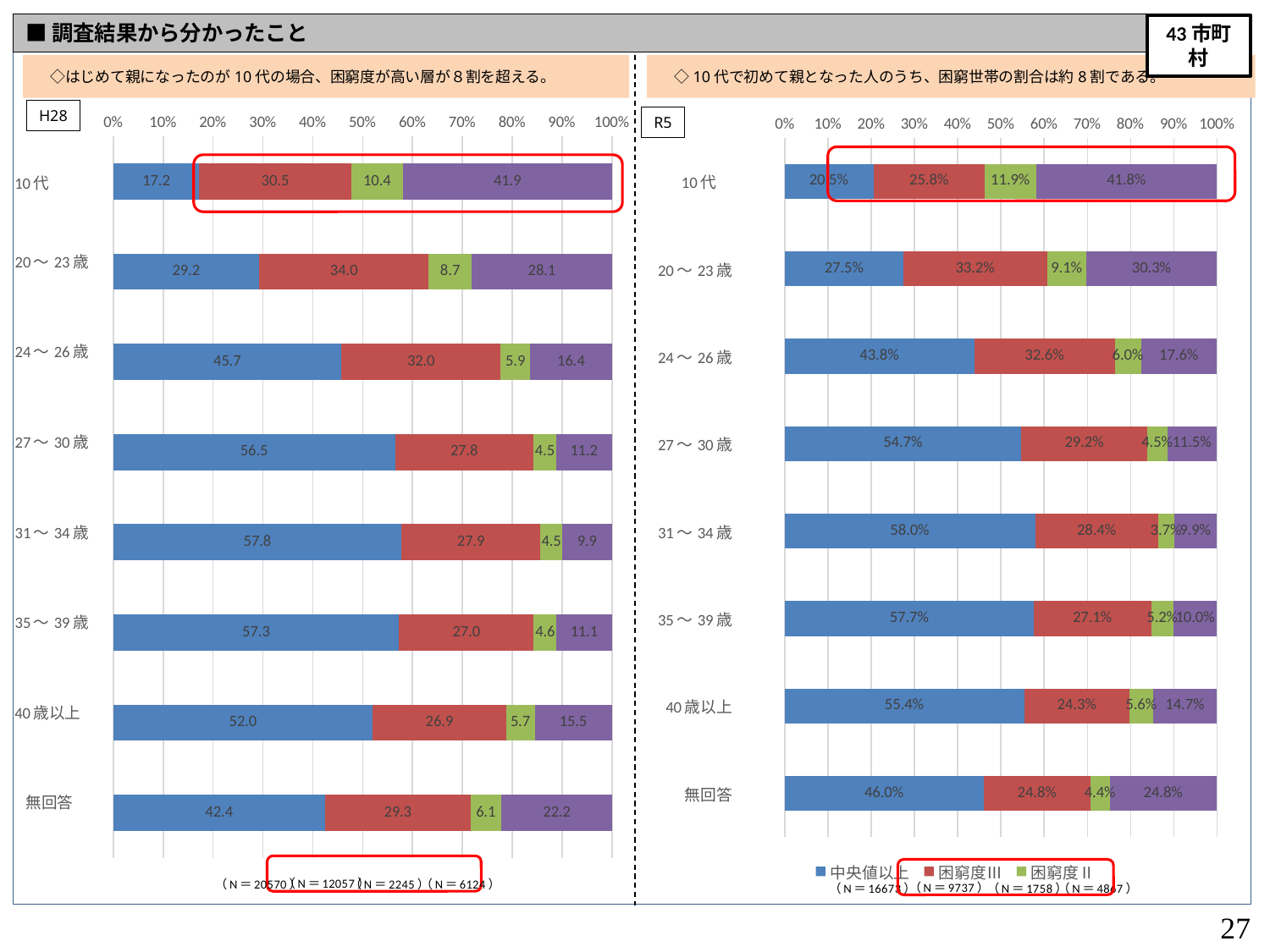
In the left chart (H28), what is the value of 困窮度III for 無回答? 29.3 In the right chart (R5), what is the value of 困窮度II for 31～34歳? 3.7% How many categories are shown on the y axis of the left chart (H28)? 8 In the right chart (R5), what is the value of 中央値以上 for 40歳以上? 55.4% In the right chart (R5), which category has the lowest value for 中央値以上? 10代 In the left chart (H28), what is the value of 中央値以上 for 10代? 17.2 What kind of chart is the right chart (R5)? Stacked bar chart In the left chart (H28), which category has the highest value for 中央値以上? 31～34歳 In the right chart (R5), which has the larger 困窮度II value, 10代 or 20～23歳? 10代 In the left chart (H28), does the 中央値以上 value rise or fall from 10代 to 27～30歳? Rise In the left chart (H28), what is the difference between the 中央値以上 values for 27～30歳 and 10代? 39.3 In the right chart (R5), what is the value of 困窮度III for 20～23歳? 33.2%